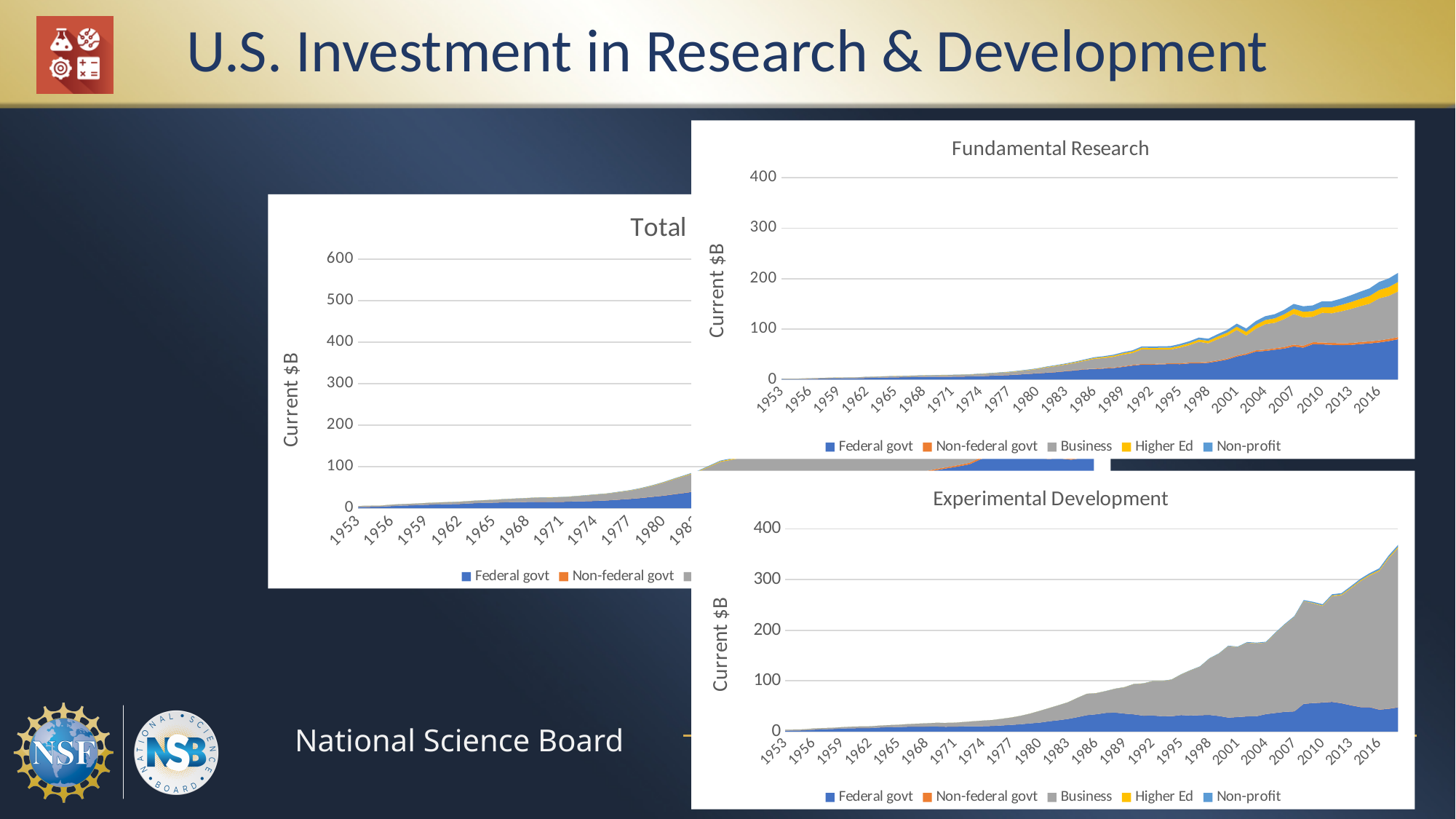
In the Experimental Development chart, do the total values rise or fall from 1953 to 2016? Rise In the Fundamental Research chart, is the total value in 2016 greater or less than 300? less In the Experimental Development chart, is the total value in 2016 greater or less than 300? greater In the Experimental Development chart, is the Federal govt value in 2016 greater or less than 100? less What is the y-axis label on the Experimental Development chart? Current $B How many series does the legend of the Fundamental Research chart list? 5 Which series is shown in grey in the Fundamental Research chart's legend? Business In the Fundamental Research chart, do the total values rise or fall from 1953 to 2016? Rise What kind of chart is the Fundamental Research chart? Stacked area chart What kind of chart is the Experimental Development chart? Stacked area chart How many series does the legend of the Experimental Development chart list? 5